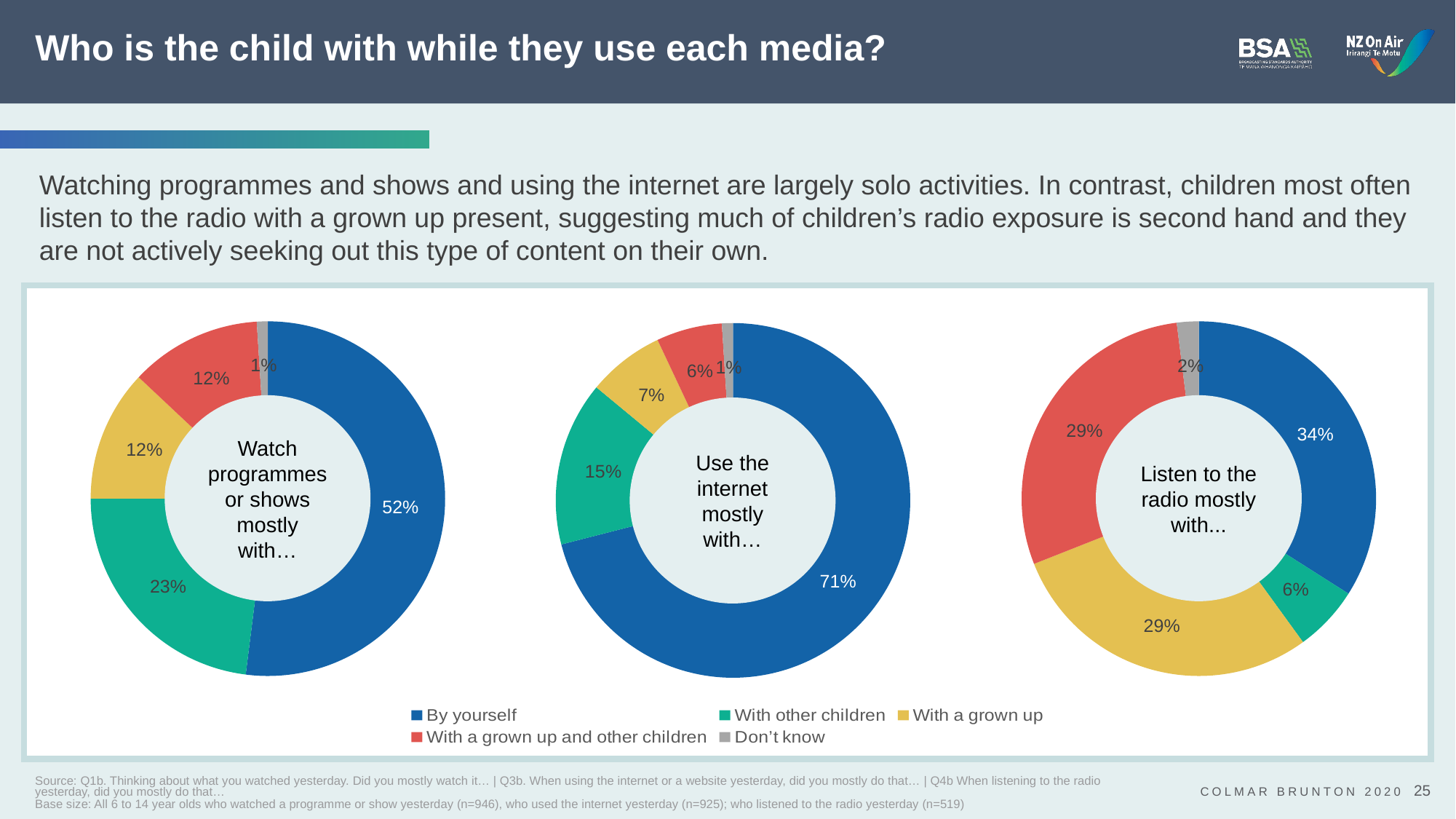
In the 'Listen to the radio mostly with...' chart, what share is 'With other children'? 6% In the 'Use the internet mostly with…' chart, what share is 'By yourself'? 71% In the 'Watch programmes or shows mostly with…' chart, which category has the largest share? By yourself In the 'Listen to the radio mostly with...' chart, what share is 'With a grown up'? 29% In the 'Listen to the radio mostly with...' chart, what is the difference between 'By yourself' and 'With other children'? 28% What kind of chart is used on this slide? Donut (pie) chart Which is larger: 'By yourself' in the 'Use the internet mostly with…' chart or 'By yourself' in the 'Watch programmes or shows mostly with…' chart? Use the internet mostly with… How many series does the legend list? 5 In the 'Use the internet mostly with…' chart, what share is 'With other children'? 15% Which colour represents 'With a grown up' in the legend? Yellow In the 'Watch programmes or shows mostly with…' chart, what share is 'By yourself'? 52% In the 'Use the internet mostly with…' chart, which category has the smallest share? Don't know